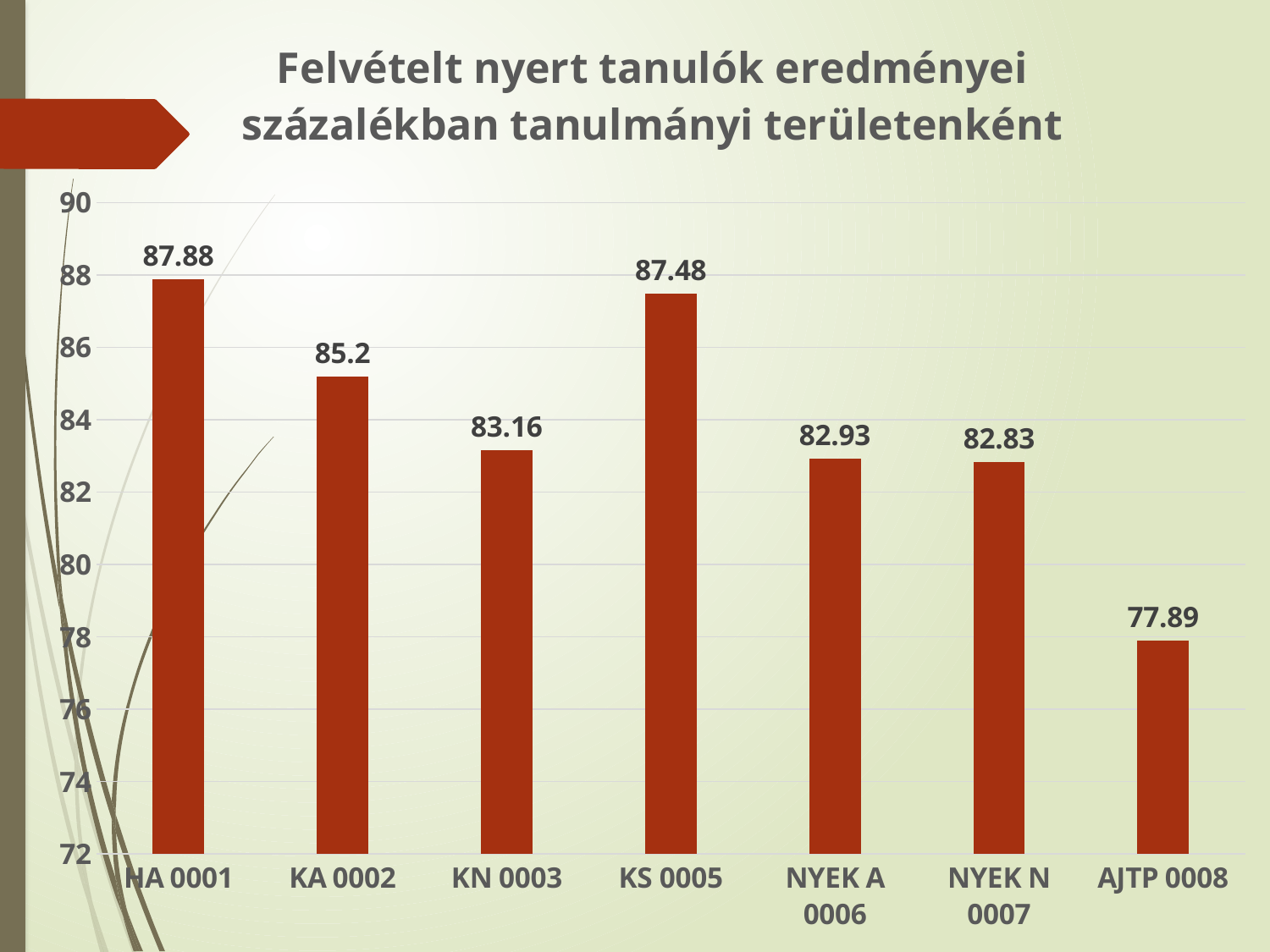
What is the value for NYEK N 0007? 82.83 Is the value for KN 0003 greater or less than 82? greater What is the value for AJTP 0008? 77.89 How many categories are shown on the x axis? 7 Which category has the highest value? HA 0001 What is the value for HA 0001? 87.88 Which category has the lowest value? AJTP 0008 What is the difference between the values for HA 0001 and AJTP 0008? 9.99 What is the value for KS 0005? 87.48 What kind of chart is shown on the slide? bar chart Which is larger, the value for KS 0005 or the value for KA 0002? KS 0005 What is the difference between the values for KA 0002 and KN 0003? 2.04